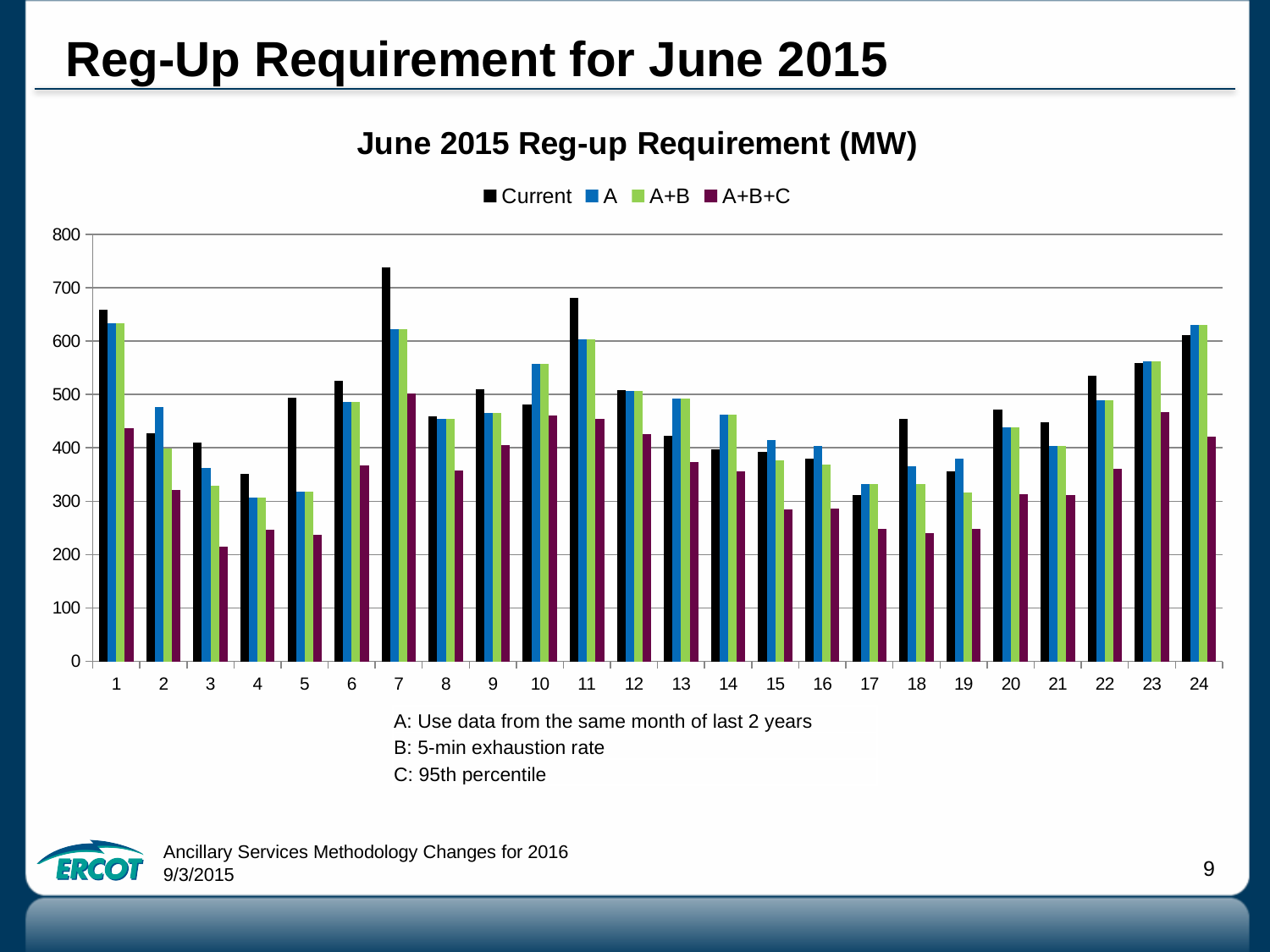
How many categories (hours) are shown along the x axis? 24 Is the Current value for hour 7 greater or less than 700? greater For which hour is the Current Reg-up requirement lowest? 17 For which hour is the A+B+C Reg-up requirement highest? 7 How many series does the legend list? 4 What is the title of the chart? June 2015 Reg-up Requirement (MW) Which is larger for hour 2: the Current value or the A value? A For which hour is the Current Reg-up requirement highest? 7 What colour represents the A+B+C series in the legend? Purple Is the A value for hour 24 greater or less than 600? greater Is the A+B+C value for hour 3 greater or less than 300? less What kind of chart is shown on the slide? Bar chart